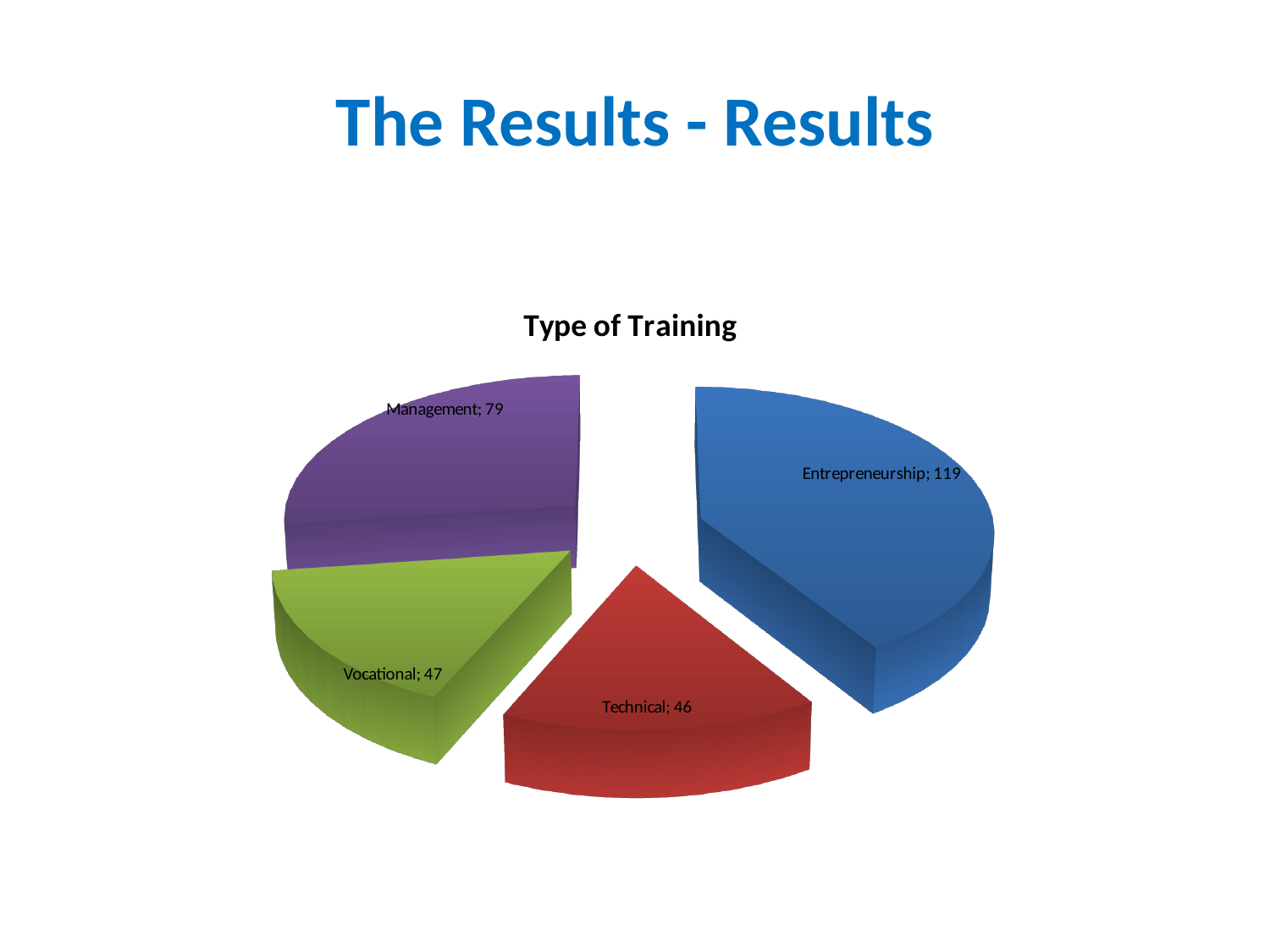
What is the value for Management in the Type of Training pie chart? 79 How many slices does the Type of Training pie chart have? 4 What is the title of the chart on the slide? Type of Training What is the value for Technical in the Type of Training pie chart? 46 Which type of training has the largest slice in the pie chart? Entrepreneurship Which is larger, the value for Management or the value for Vocational? Management Which type of training has the smallest value in the pie chart? Technical What is the difference between the Entrepreneurship and Management values? 40 What is the value for Entrepreneurship in the Type of Training pie chart? 119 What is the value for Vocational in the Type of Training pie chart? 47 What kind of chart is shown on the slide? Pie chart What is the difference between the Vocational and Technical values? 1